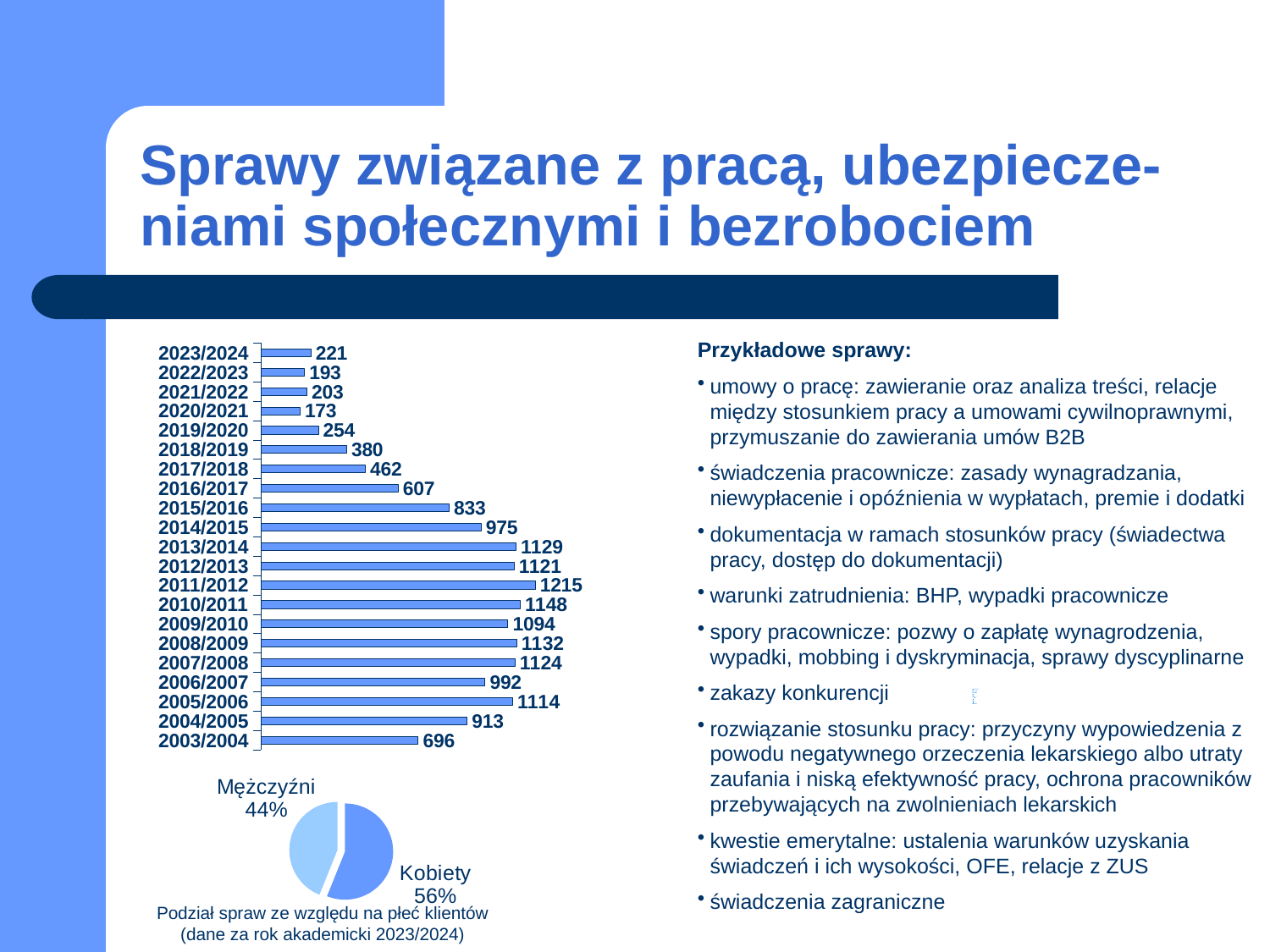
In the bar chart, what is the value for 2003/2004? 696 In the bar chart, which academic year has the lowest value? 2020/2021 In the bar chart, which is larger: the value for 2016/2017 or the value for 2017/2018? 2016/2017 In the bar chart, what is the difference between the values for 2019/2020 and 2020/2021? 81 What kind of chart is the upper chart on the slide? bar chart In the bar chart, what is the value for 2011/2012? 1215 In the pie chart, what share is labelled Kobiety? 56% How many academic years are shown in the bar chart? 21 In the bar chart, what is the value for 2023/2024? 221 In the bar chart, which academic year has the highest value? 2011/2012 In the pie chart, what share is labelled Mężczyźni? 44% In the bar chart, do the values rise or fall from 2014/2015 to 2023/2024? fall